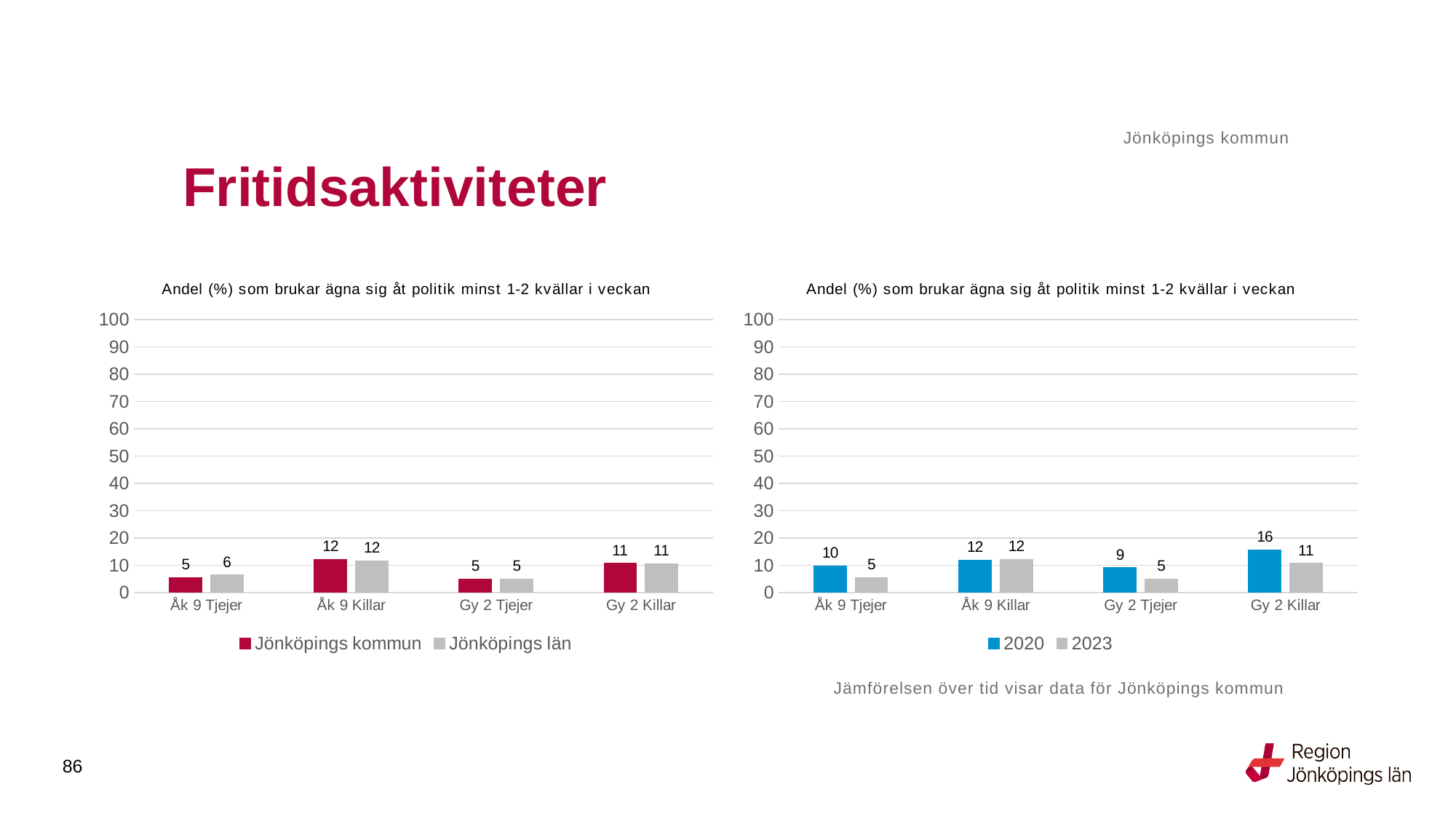
How many series does the legend of the right chart list? 2 What kind of chart is the left chart? Bar chart What are the two legend entries of the left chart? Jönköpings kommun and Jönköpings län In the right chart, which is larger for Åk 9 Tjejer: the 2020 value or the 2023 value? 2020 In the right chart, what is the 2023 value for Gy 2 Tjejer? 5 In the left chart, what is the value for Jönköpings kommun for Åk 9 Killar? 12 In the left chart, what is the value for Jönköpings län for Åk 9 Tjejer? 6 In the left chart, which category has the lowest Jönköpings län value? Gy 2 Tjejer In the right chart, what is the 2020 value for Gy 2 Killar? 16 How many categories are shown on the x axis of the left chart? 4 In the right chart, which category has the highest 2020 value? Gy 2 Killar In the right chart, what is the difference between the 2020 and 2023 values for Gy 2 Killar? 5